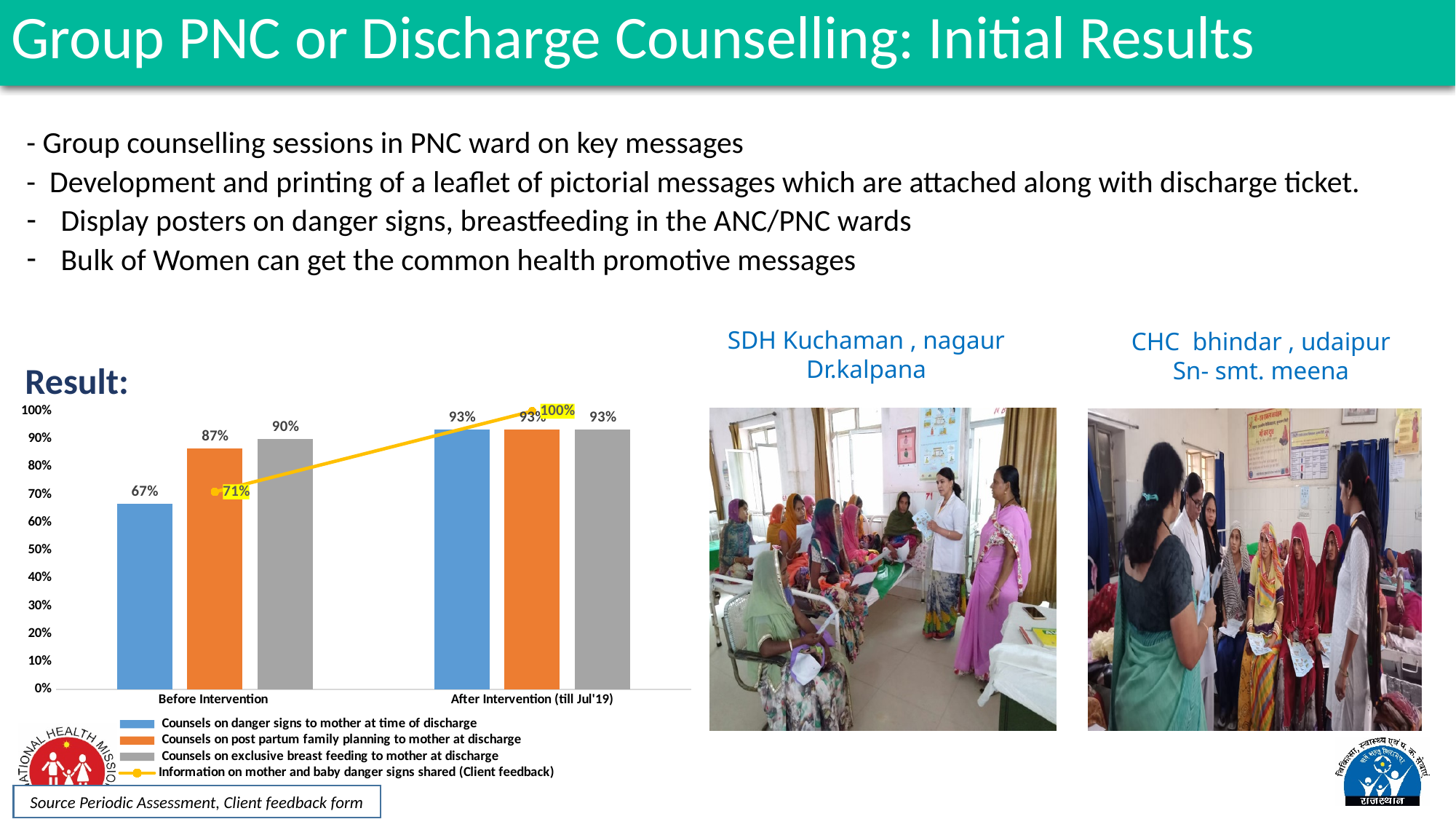
Which series has the lowest value before intervention? Counsels on danger signs to mother at time of discharge What is the value for 'Counsels on danger signs to mother at time of discharge' before intervention? 67% What is the value for 'Counsels on post partum family planning to mother at discharge' before intervention? 87% What is the value for 'Information on mother and baby danger signs shared (Client feedback)' before intervention? 71% How many categories are shown on the x axis? 2 How many series does the legend list? 4 What is the value for 'Information on mother and baby danger signs shared (Client feedback)' after intervention (till Jul'19)? 100% Which is larger before intervention: 'Counsels on post partum family planning to mother at discharge' or 'Counsels on exclusive breast feeding to mother at discharge'? Counsels on exclusive breast feeding to mother at discharge By how many percentage points did 'Counsels on danger signs to mother at time of discharge' increase from before intervention to after intervention? 26 percentage points Do the values rise or fall from before intervention to after intervention? rise What is the value for 'Counsels on exclusive breast feeding to mother at discharge' before intervention? 90% What colour represents 'Counsels on post partum family planning to mother at discharge' in the chart? Orange